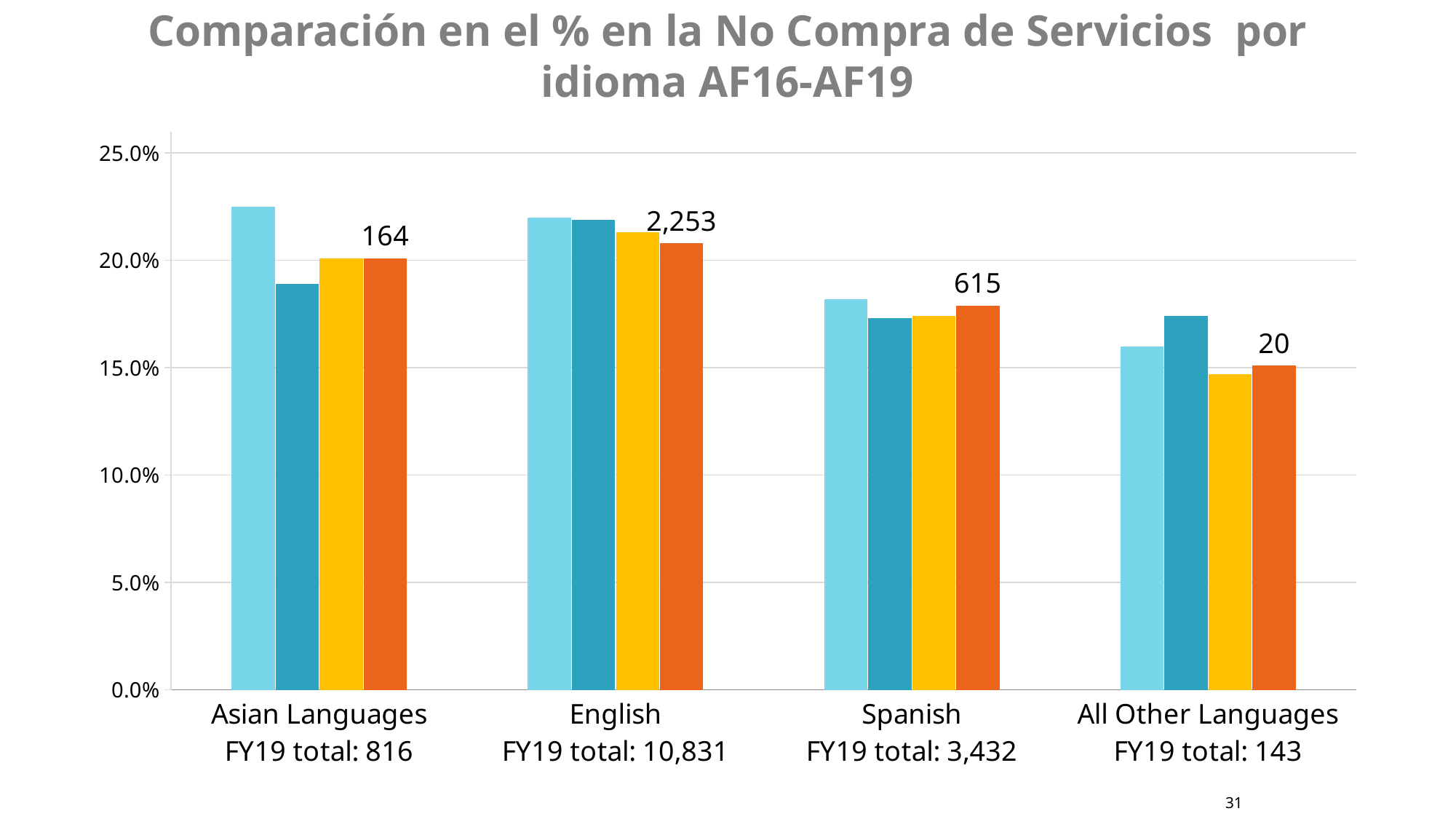
What data label is printed above the orange bar for Asian Languages? 164 Which language category has the lowest orange (fourth) bar? All Other Languages What data label is printed above the orange bar for Spanish? 615 What kind of chart is shown on the slide? bar chart What FY19 total is shown in the axis label for English? 10,831 What is the title of the chart? Comparación en el % en la No Compra de Servicios por idioma AF16-AF19 How many bars are plotted for each language category? 4 Is the value of the light blue (first) bar for Spanish greater or less than 20.0%? less How many language categories are shown on the x axis? 4 What data label is printed above the orange bar for All Other Languages? 20 What data label is printed above the orange bar for English? 2,253 Is the value of the light blue (first) bar for Asian Languages greater or less than 20.0%? greater